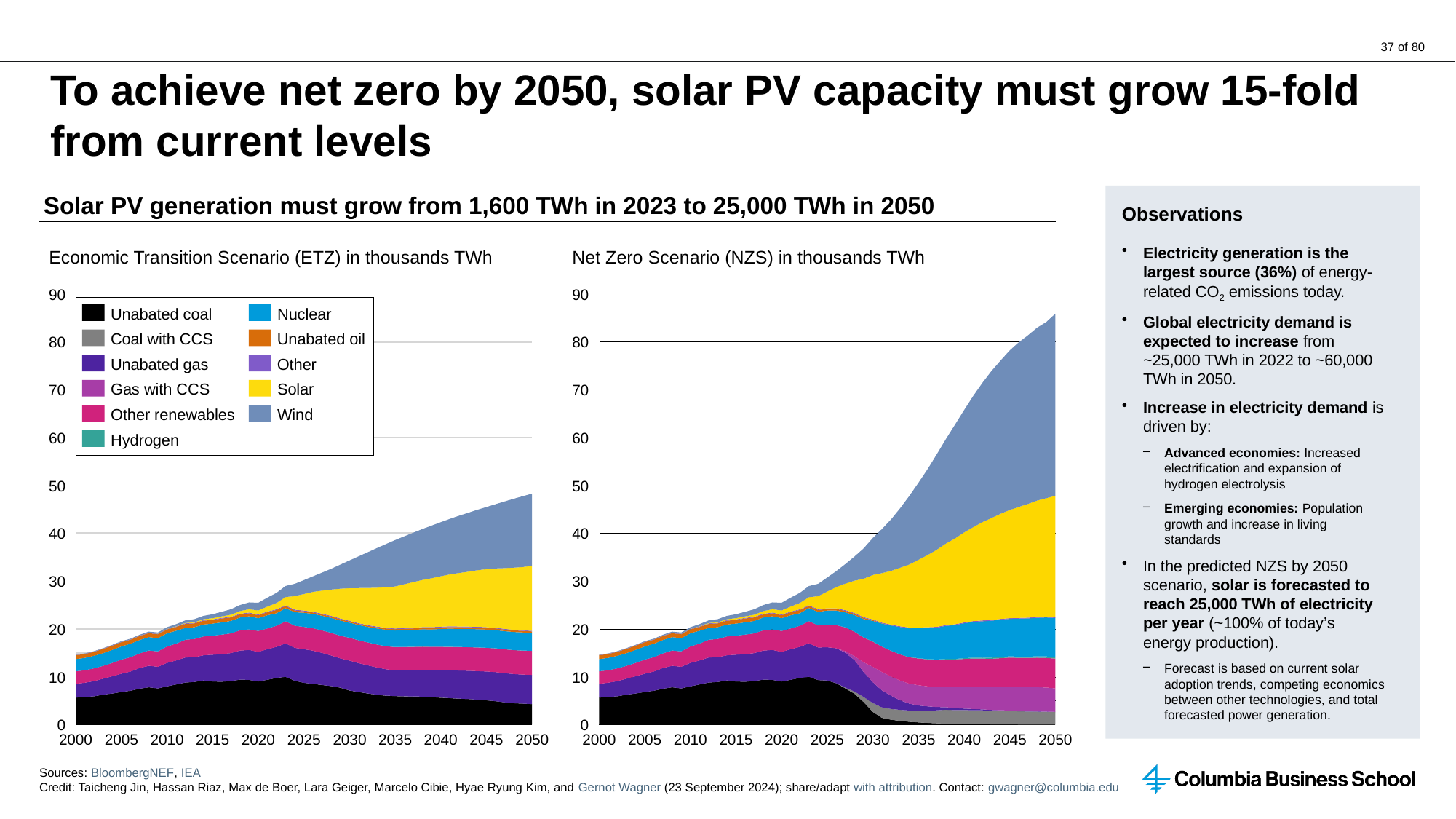
In the Net Zero Scenario (NZS) chart, is the total generation in 2050 greater or less than 80? greater Which chart shows the higher total generation in 2050, the Economic Transition Scenario (ETZ) chart or the Net Zero Scenario (NZS) chart? Net Zero Scenario (NZS) In the Economic Transition Scenario (ETZ) chart, is the total generation in 2000 greater or less than 20? less In the Economic Transition Scenario (ETZ) chart, is the total generation in 2050 greater or less than 40? greater What unit is stated in the title of the Net Zero Scenario (NZS) chart? thousands TWh What kind of chart is the Economic Transition Scenario (ETZ) chart? Stacked area chart In the Net Zero Scenario (NZS) chart, does total generation rise or fall from 2000 to 2050? Rise How many year labels are shown on the x axis of the Economic Transition Scenario (ETZ) chart? 11 In the legend of the Economic Transition Scenario (ETZ) chart, which series is shown in yellow? Solar How many series does the legend on the Economic Transition Scenario (ETZ) chart list? 11 In the Net Zero Scenario (NZS) chart, does the Unabated coal area grow or shrink between 2025 and 2035? Shrink